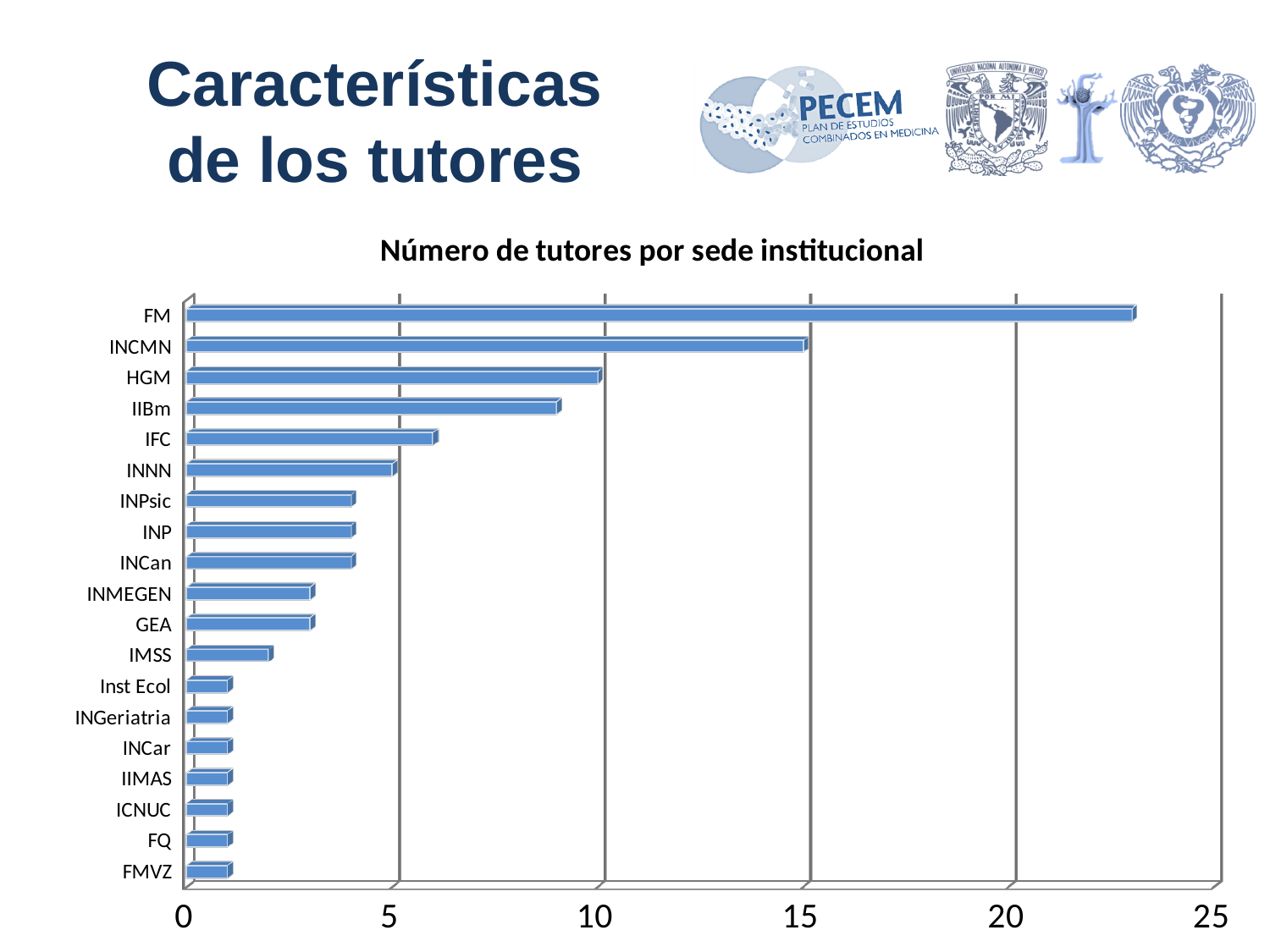
Is the value for FM greater or less than 20? greater Which has more tutores, FM or INCMN? FM Is the value for IFC greater or less than 5? greater Is the value for IMSS greater or less than 5? less Which sede institucional has the highest number of tutores? FM What is the number of tutores for HGM? 10 What is the title of the chart? Número de tutores por sede institucional What kind of chart is shown on the slide? bar chart How many sedes institucionales are listed on the chart? 19 What is the number of tutores for INCMN? 15 What is the number of tutores for INNN? 5